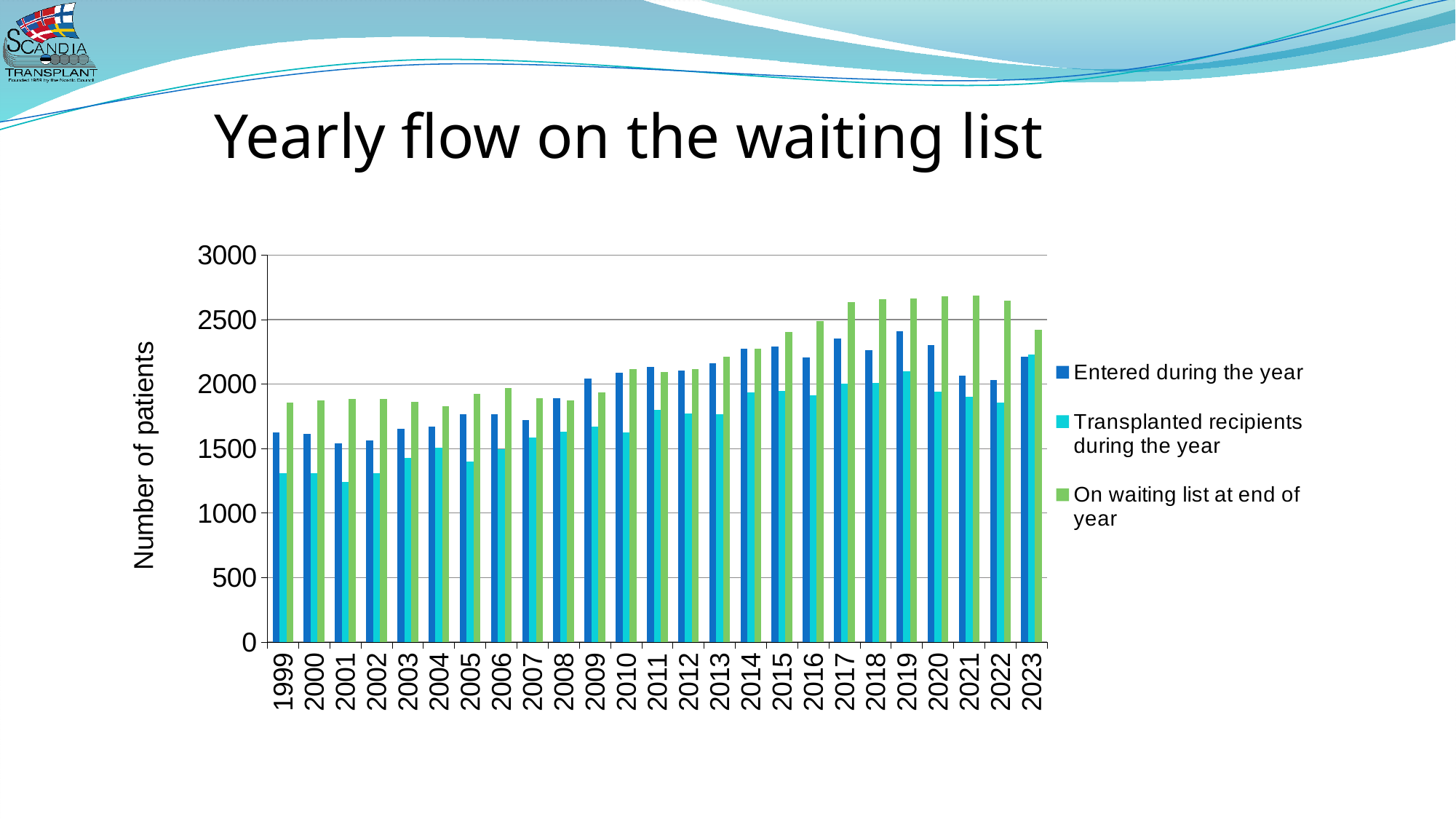
In which year is the value for 'Transplanted recipients during the year' highest? 2023 What kind of chart is shown on the slide? bar chart In 2019, which is larger: 'Entered during the year' or 'Transplanted recipients during the year'? Entered during the year How many series does the legend list? 3 Is the value for 'Transplanted recipients during the year' in 2001 greater or less than 1500? less Is the value for 'On waiting list at end of year' in 2021 greater or less than 2500? greater How many years are shown on the x axis? 25 What is the label of the vertical axis? Number of patients Is the value for 'On waiting list at end of year' in 2023 greater or less than 2500? less In which year is the value for 'Transplanted recipients during the year' lowest? 2001 What is the title of the slide's chart? Yearly flow on the waiting list